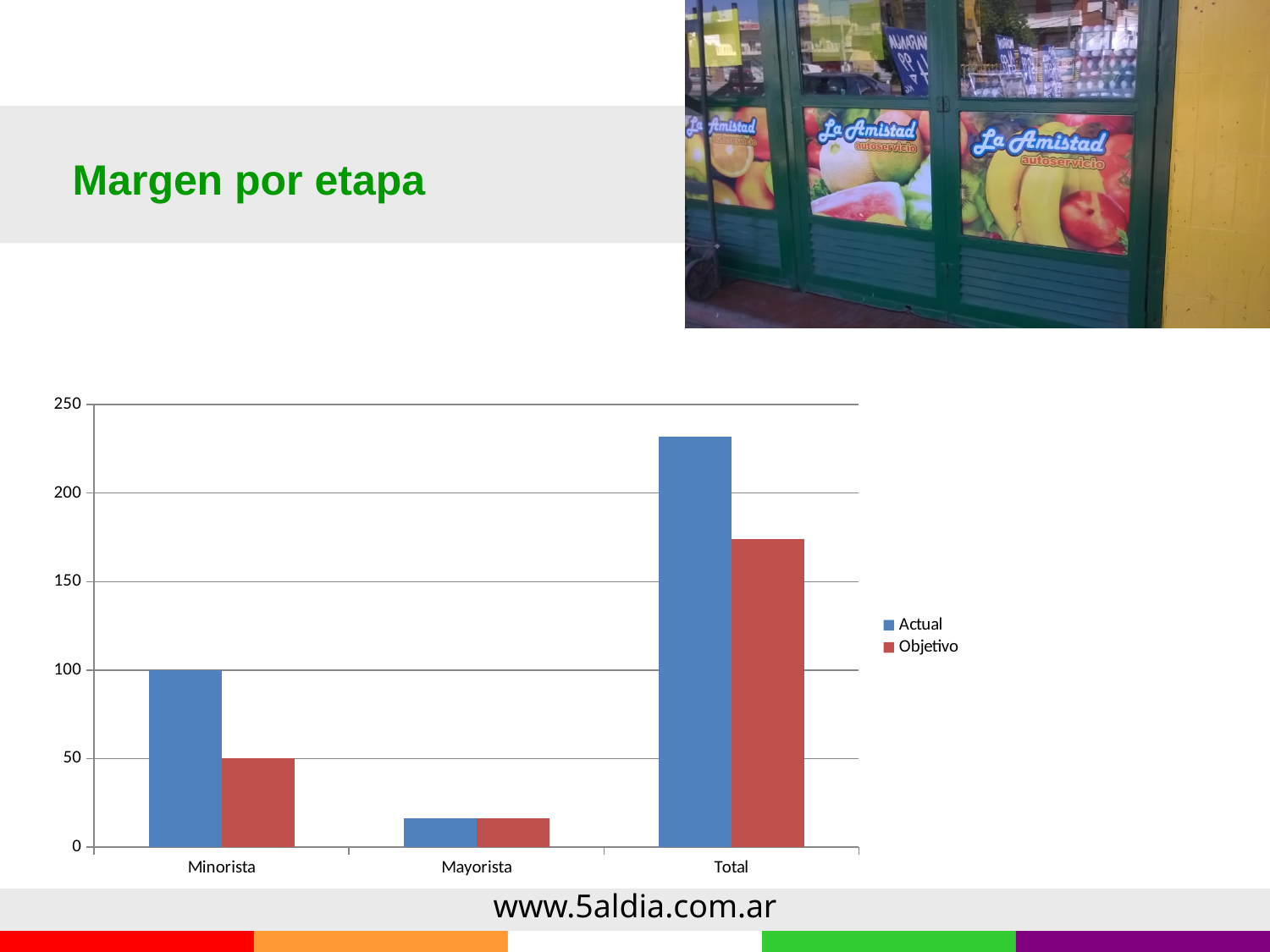
What are the two series named in the chart's legend? Actual and Objetivo For the Total category, which is larger, the Actual value or the Objetivo value? Actual Which category has the highest Actual value? Total How many series does the chart's legend list? 2 Which category has the lowest Actual value? Mayorista Is the Objetivo value for Total greater or less than 150? greater Is the Actual value for Mayorista greater or less than 50? less What is the title of the slide containing the chart? Margen por etapa How many categories are shown on the x axis of the chart? 3 Which category has the lowest Objetivo value? Mayorista Is the Actual value for Total greater or less than 200? greater What kind of chart is shown on the slide? bar chart